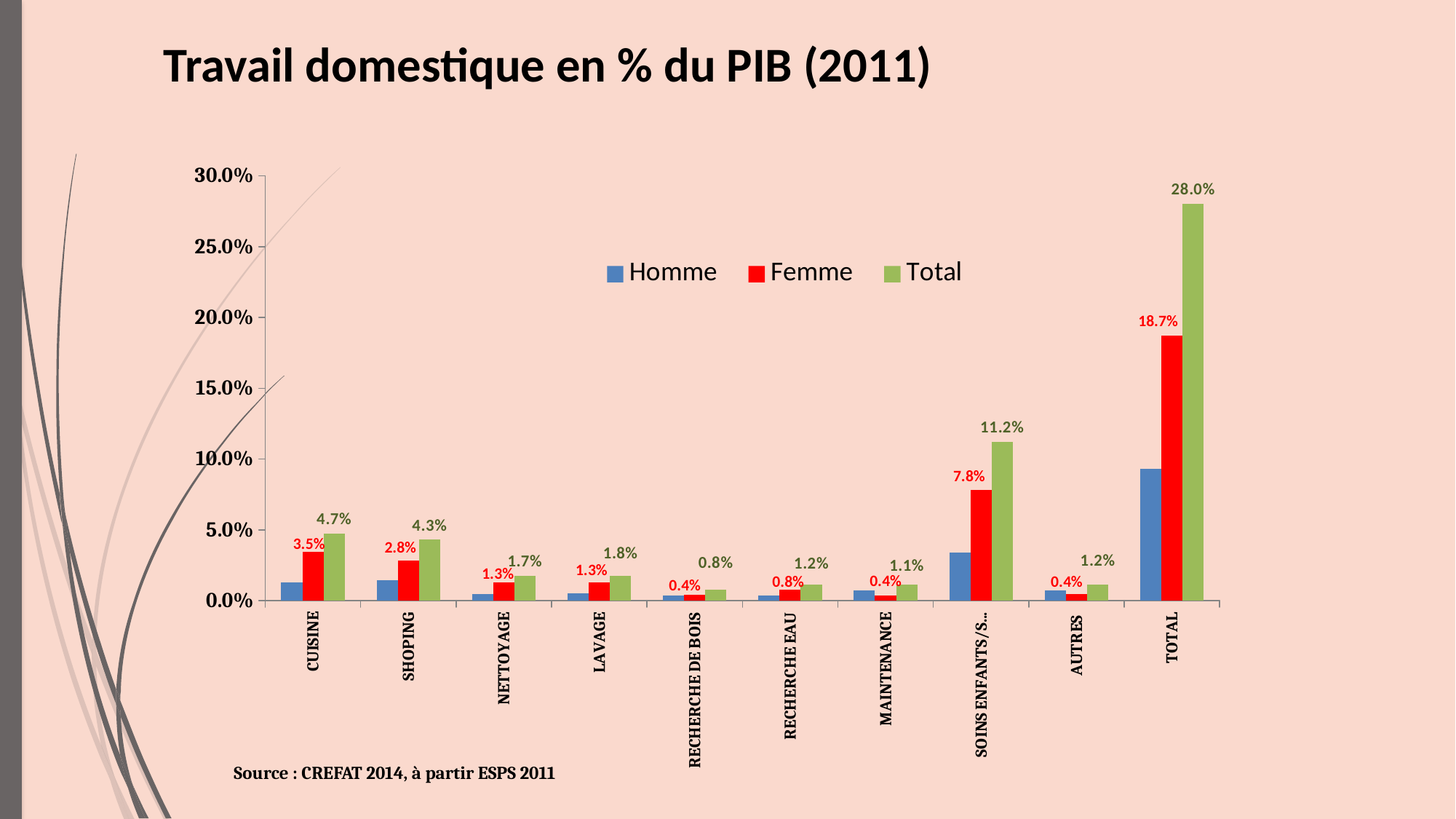
What is the Femme value for TOTAL? 18.7% How many categories are shown on the x axis? 10 How many series does the legend list? 3 What is the Total value for SOINS ENFANTS? 11.2% What is the difference between the Total value and the Femme value for TOTAL? 9.3% Is the Homme value for TOTAL greater or less than 10.0%? less Which category has the lowest Total value? RECHERCHE DE BOIS What is the Femme value for CUISINE? 3.5% Which is larger, the Femme value for CUISINE or the Femme value for SHOPING? CUISINE Excluding the TOTAL category, which category has the highest Total value? SOINS ENFANTS What type of chart is shown on the slide? bar chart What is the Total value for SHOPING? 4.3%